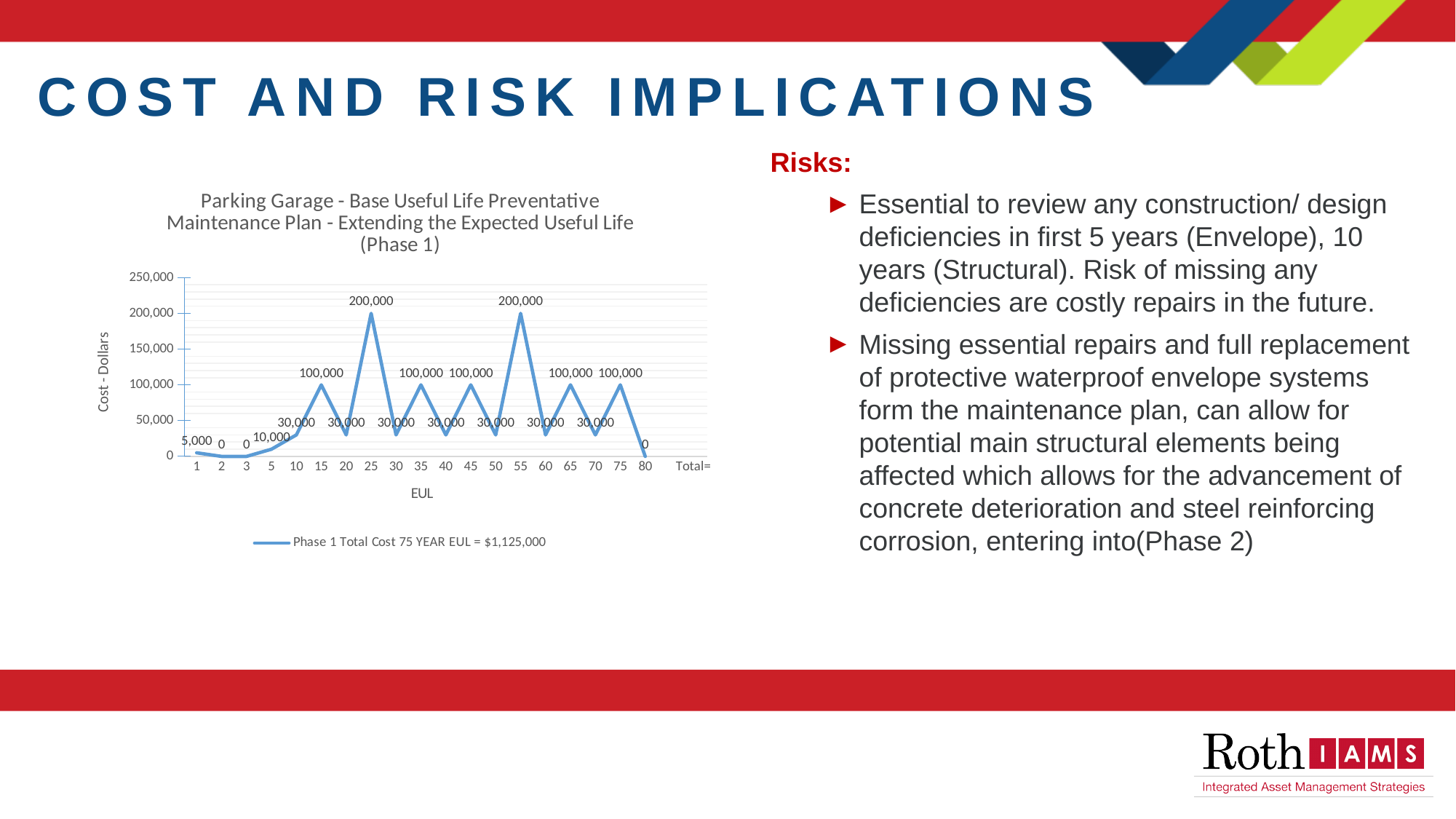
What is the plotted cost at EUL 1? 5,000 Which has the larger cost, EUL 10 or EUL 15? EUL 15 What is the plotted cost at EUL 80? 0 What is the highest cost value plotted on the chart? 200,000 What is the plotted cost at EUL 25? 200,000 How many series does the chart legend list? 1 What kind of chart is shown on the slide? line chart What is the difference between the cost at EUL 25 and the cost at EUL 20? 170,000 Is the cost at EUL 10 greater or less than 50,000? less What is the plotted cost at EUL 5? 10,000 What is the plotted cost at EUL 15? 100,000 What is the legend entry for the plotted series? Phase 1 Total Cost 75 YEAR EUL = $1,125,000